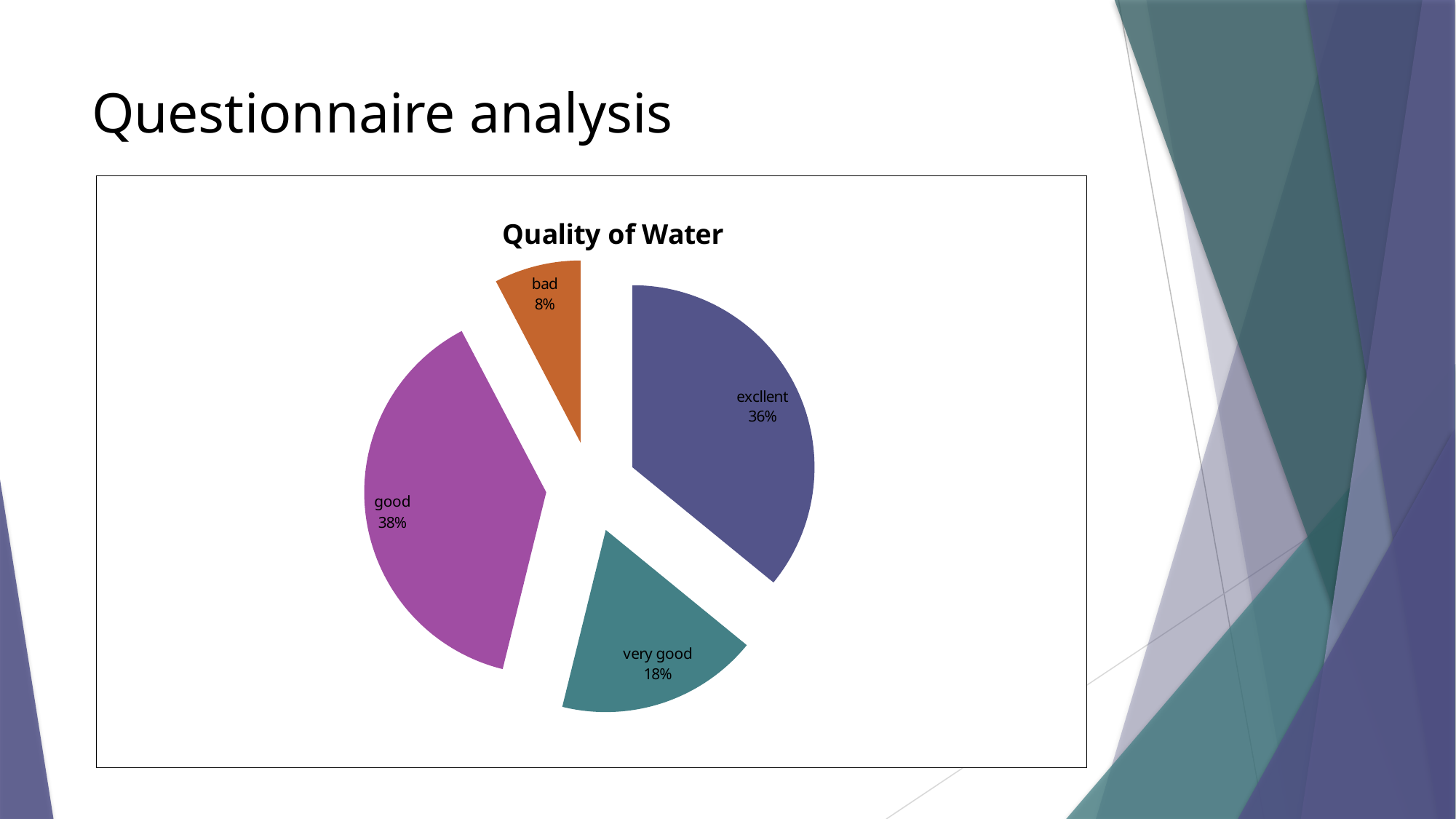
What percentage of the pie is labelled "bad"? 8% What percentage of the pie is labelled "excllent"? 36% What percentage of the pie is labelled "good"? 38% What is the title of the chart? Quality of Water Which slice of the pie is the smallest? bad What percentage of the pie is labelled "very good"? 18% What kind of chart is shown on the slide? pie chart Which slice of the pie is the largest? good How many slices does the pie chart have? 4 What colour is the "bad" slice? orange What is the difference in percentage points between the "good" and "very good" slices? 20 Which slice is larger, "very good" or "bad"? very good